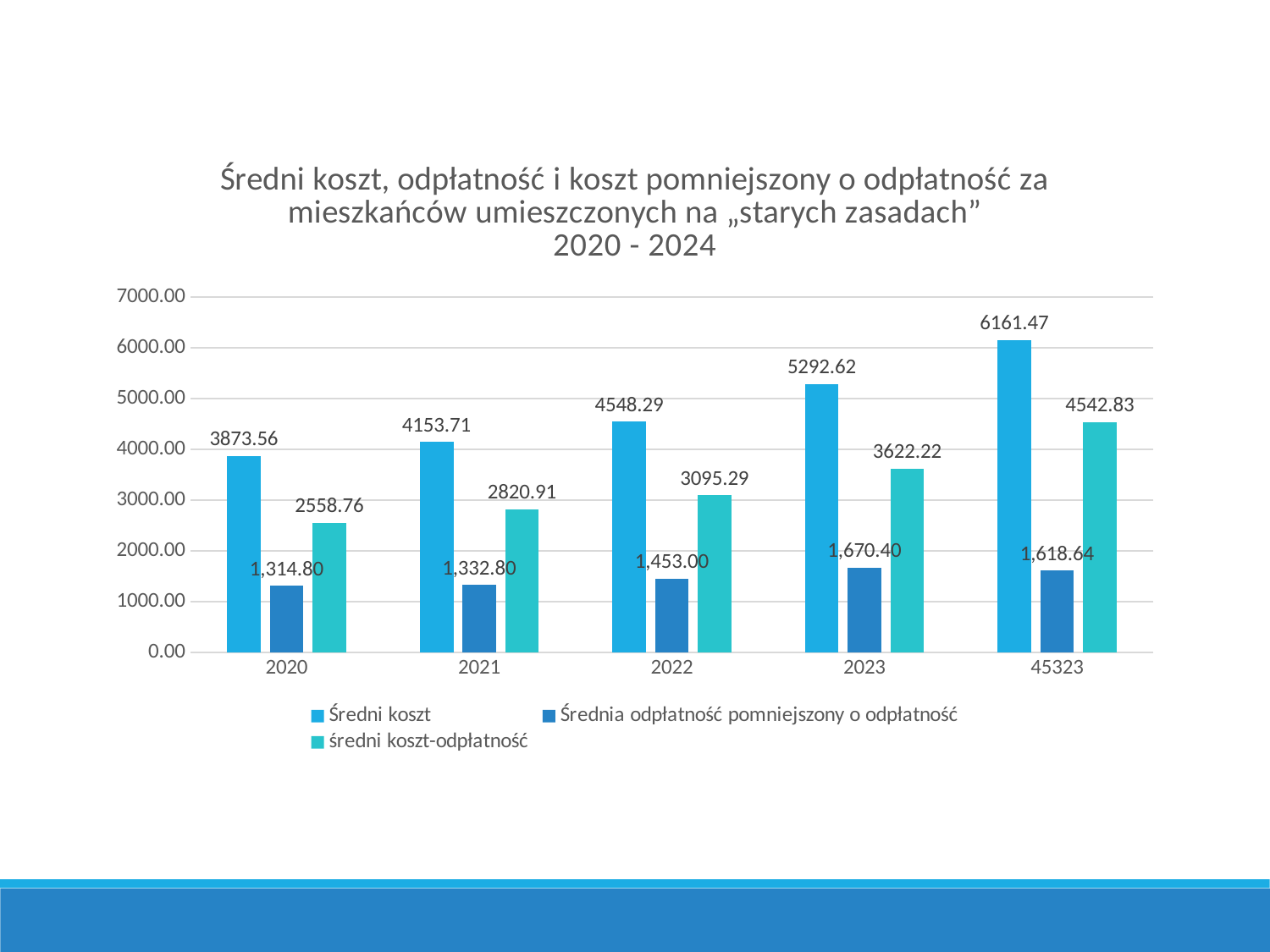
What is the value of Średni koszt for 2020? 3873.56 Which is larger: Średnia odpłatność pomniejszony o odpłatność for 2023 or for 45323? 2023 Which category has the highest Średni koszt value? 45323 What is the difference between the Średni koszt values for 45323 and 2020? 2287.91 How many categories are shown on the x axis? 5 What is the value of Średni koszt for the category labelled 45323? 6161.47 Which category has the lowest średni koszt-odpłatność value? 2020 What is the value of Średnia odpłatność pomniejszony o odpłatność for 2022? 1,453.00 How many series does the legend list? 3 What is the difference between Średni koszt and średni koszt-odpłatność for 2020? 1314.80 Does the Średni koszt series rise or fall from 2020 to 45323? rise What is the value of średni koszt-odpłatność for 2023? 3622.22